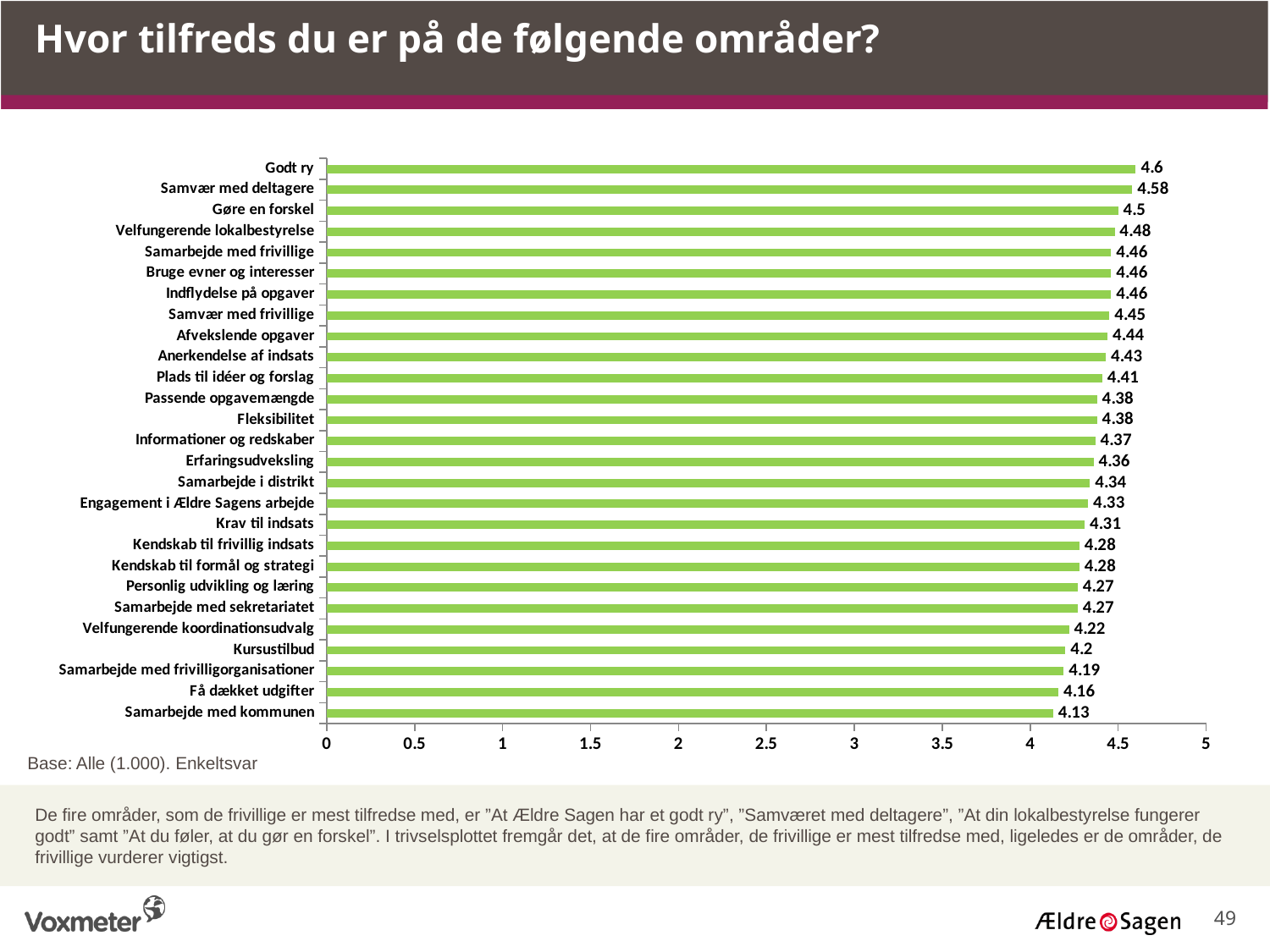
What is the value for Kursustilbud? 4.2 What kind of chart is shown on the slide? Bar chart What is the value for Godt ry? 4.6 Is the value for Få dækket udgifter greater or less than 4.5? less What is the difference between the values for Godt ry and Samarbejde med kommunen? 0.47 What is the value for Samarbejde med kommunen? 4.13 Which category has the lowest value? Samarbejde med kommunen Which category has the highest value? Godt ry What is the value for Fleksibilitet? 4.38 Which is larger, the value for Gøre en forskel or the value for Erfaringsudveksling? Gøre en forskel How many categories are shown in the chart? 27 What is the title of the slide? Hvor tilfreds du er på de følgende områder?